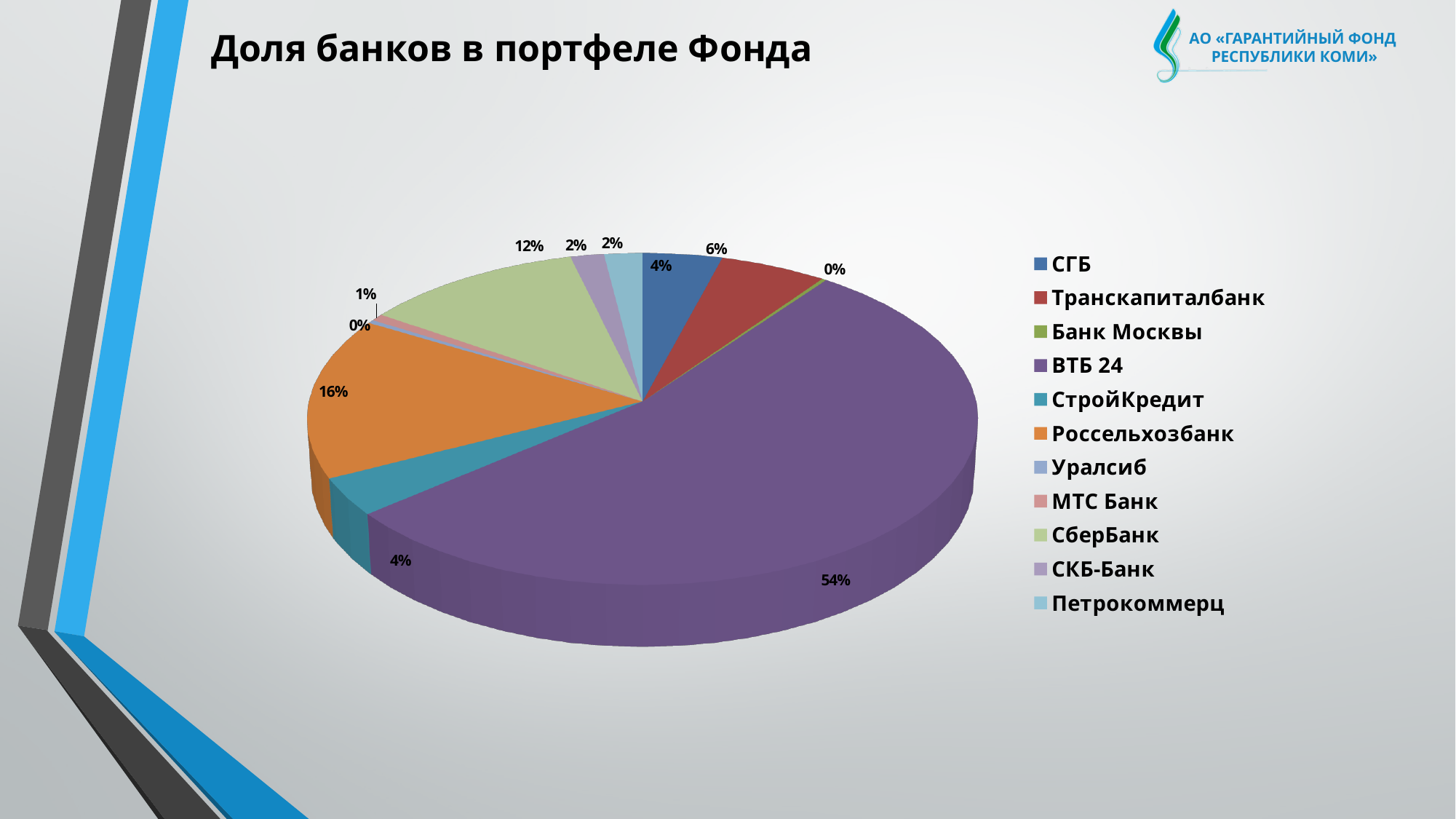
What share of the portfolio does МТС Банк hold? 1% What share of the portfolio does СберБанк hold? 12% Which has the larger share, Россельхозбанк or СберБанк? Россельхозбанк What colour is the slice for ВТБ 24? purple Which bank has the largest share of the portfolio? ВТБ 24 What share of the portfolio does ВТБ 24 hold? 54% What is the difference between the shares of ВТБ 24 and Россельхозбанк? 38% What share of the portfolio does Россельхозбанк hold? 16% How many banks does the legend list? 11 What is the title of the chart? Доля банков в портфеле Фонда What share of the portfolio does Транскапиталбанк hold? 6% What kind of chart is shown on the slide? pie chart